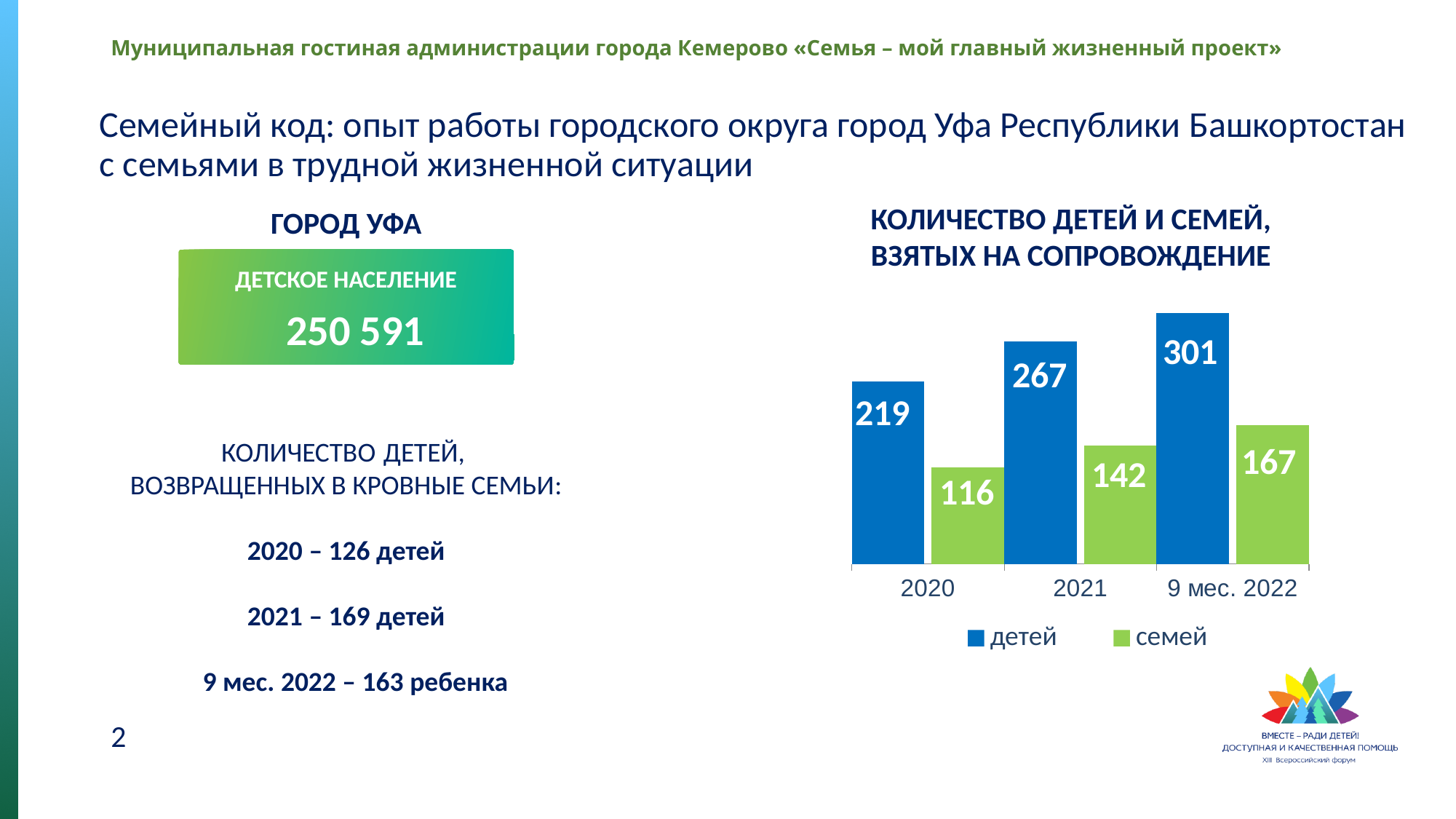
How many periods are shown on the x axis of the chart? 3 What kind of chart is shown on the slide? bar chart What is the value for детей in 9 мес. 2022? 301 Which period has the highest value for семей? 9 мес. 2022 What is the value for детей in 2020? 219 Which is larger: семей in 2020 or семей in 9 мес. 2022? семей in 9 мес. 2022 What is the difference between детей and семей in 2021? 125 Do the values for детей rise or fall from 2020 to 9 мес. 2022? rise What colour are the bars for семей? green How many series does the legend list? 2 What is the value for семей in 2021? 142 Which period has the lowest value for детей? 2020